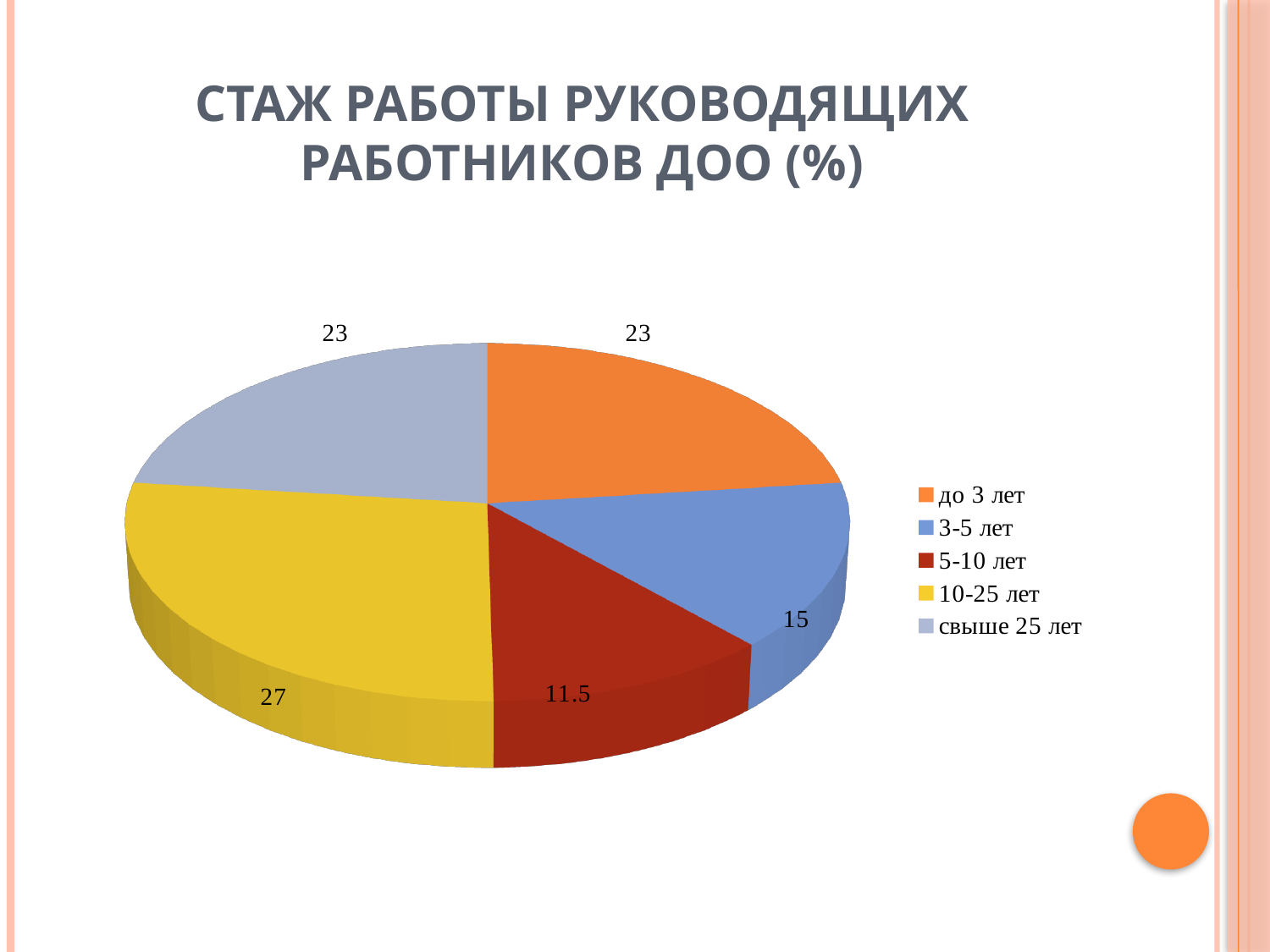
Which colour represents "10-25 лет" in the legend? Yellow What is the difference between the values for "свыше 25 лет" and "3-5 лет"? 8 Which is larger, the value for "3-5 лет" or the value for "5-10 лет"? 3-5 лет What value is shown for the "10-25 лет" slice? 27 Which category has the smallest slice of the pie? 5-10 лет Which category has the largest slice of the pie? 10-25 лет What type of chart is shown on the slide? Pie chart What value is shown for the "5-10 лет" slice? 11.5 What value is shown for the "до 3 лет" slice? 23 What is the difference between the values for "10-25 лет" and "5-10 лет"? 15.5 What value is shown for the "3-5 лет" slice? 15 How many categories does the pie chart have? 5